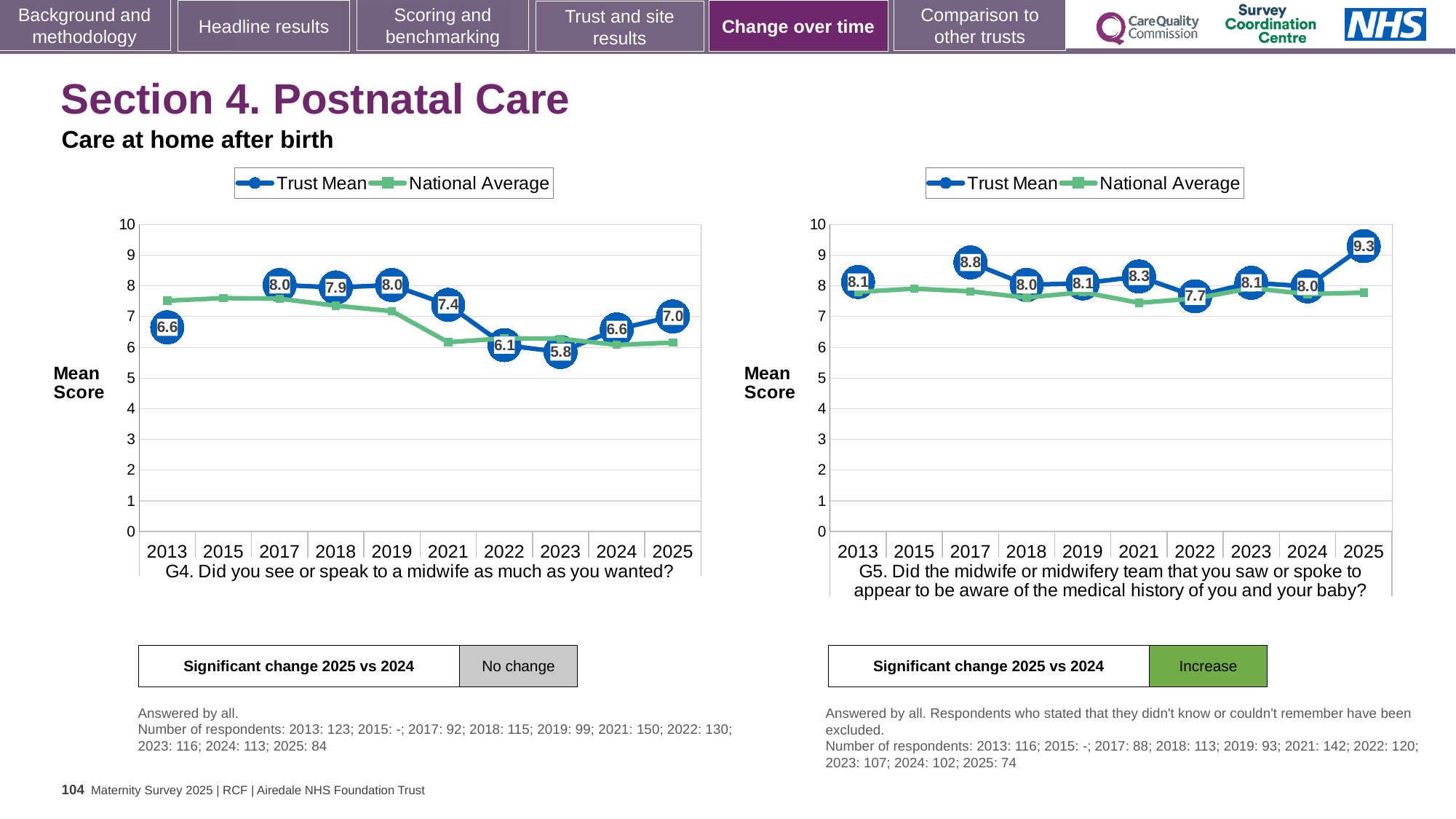
What type of chart is the G5 chart (right)? Line chart In the G4 chart (left), what is the Trust Mean for 2025? 7.0 In the G5 chart (right), which year has the lowest Trust Mean? 2022 How many years are shown on the x axis of the G5 chart (right)? 10 In the G5 chart (right), which year has the highest Trust Mean? 2025 In the G4 chart (left), is the National Average for 2013 greater or less than 7? greater In the G4 chart (left), which year has the lowest Trust Mean? 2023 In the G5 chart (right), what is the Trust Mean for 2025? 9.3 In the G4 chart (left), is the Trust Mean higher in 2017 or in 2022? 2017 How many series does the legend of the G4 chart (left) list? 2 In the G4 chart (left), what is the Trust Mean for 2023? 5.8 In the G5 chart (right), what is the difference between the Trust Mean in 2025 and in 2024? 1.3